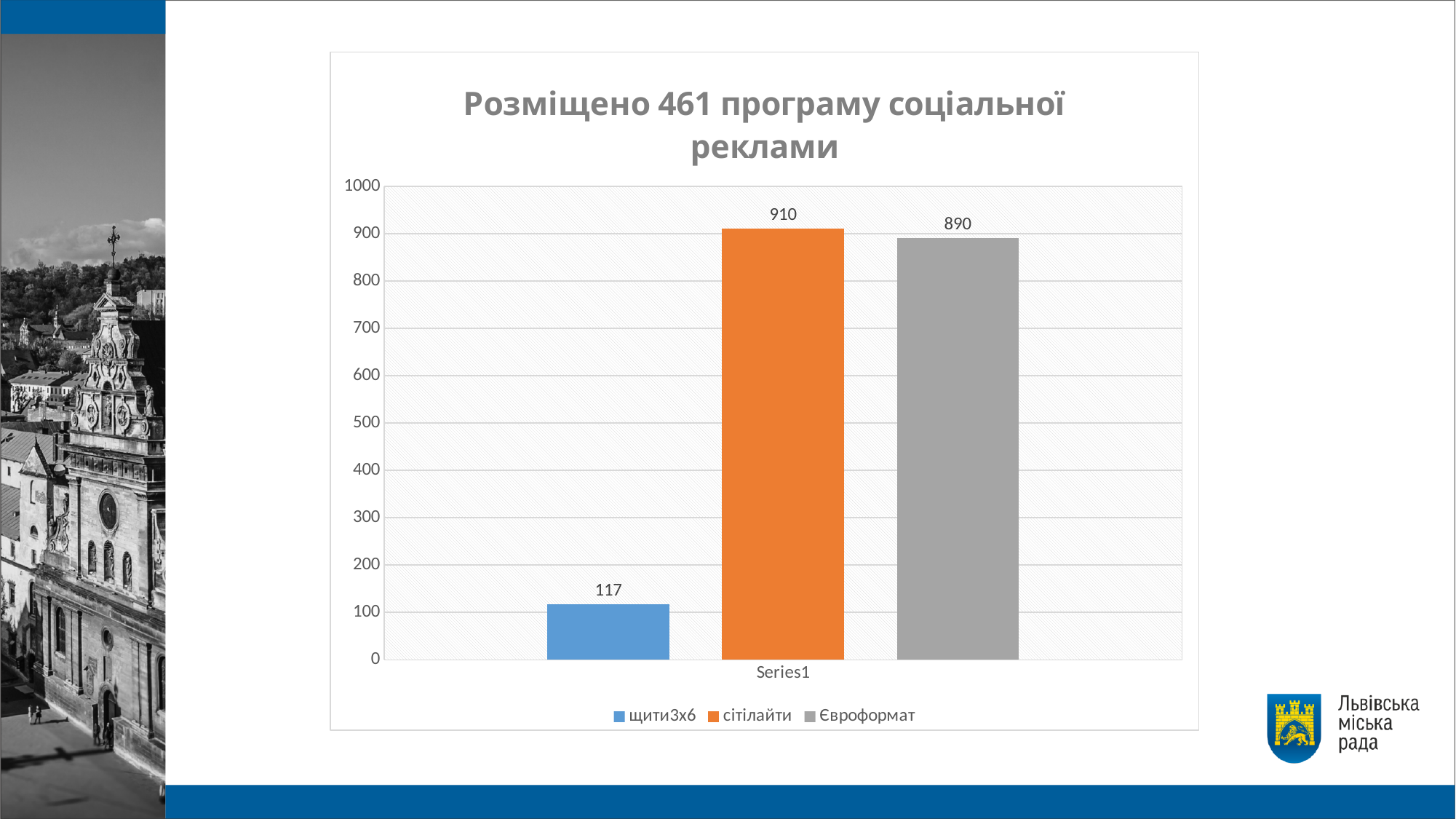
Which is larger, the value for щити3х6 or the value for Євроформат? Євроформат What is the difference between the values for сітілайти and Євроформат? 20 How many series does the legend list? 3 Which series has the highest value? сітілайти Which series has the lowest value? щити3х6 What is the value for сітілайти? 910 What is the difference between the values for Євроформат and щити3х6? 773 Is the value for щити3х6 greater or less than 200? less What is the value for щити3х6? 117 What kind of chart is shown on the slide? bar chart What is the title of the chart? Розміщено 461 програму соціальної реклами What is the value for Євроформат? 890